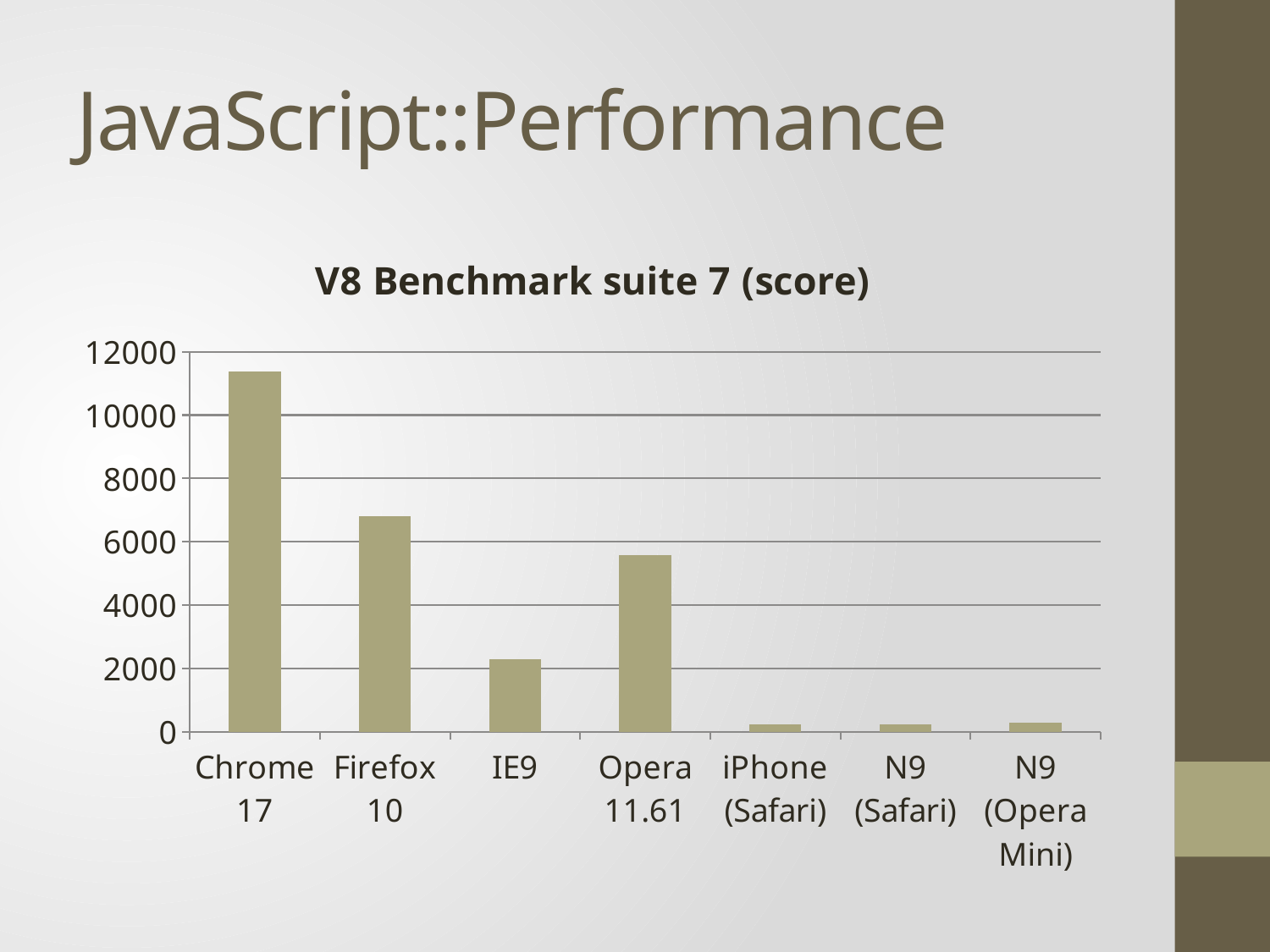
How many browsers/categories are plotted in the chart? 7 Is the value for Opera 11.61 greater or less than 6000? less Which has a higher score, Firefox 10 or Opera 11.61? Firefox 10 What is the title of the chart? V8 Benchmark suite 7 (score) Is the value for iPhone (Safari) greater or less than 2000? less Is the value for Firefox 10 greater or less than 6000? greater Which has a higher score, IE9 or N9 (Opera Mini)? IE9 Which category has the highest score in the chart? Chrome 17 What type of chart is shown on the slide? bar chart What is the maximum value shown on the vertical axis? 12000